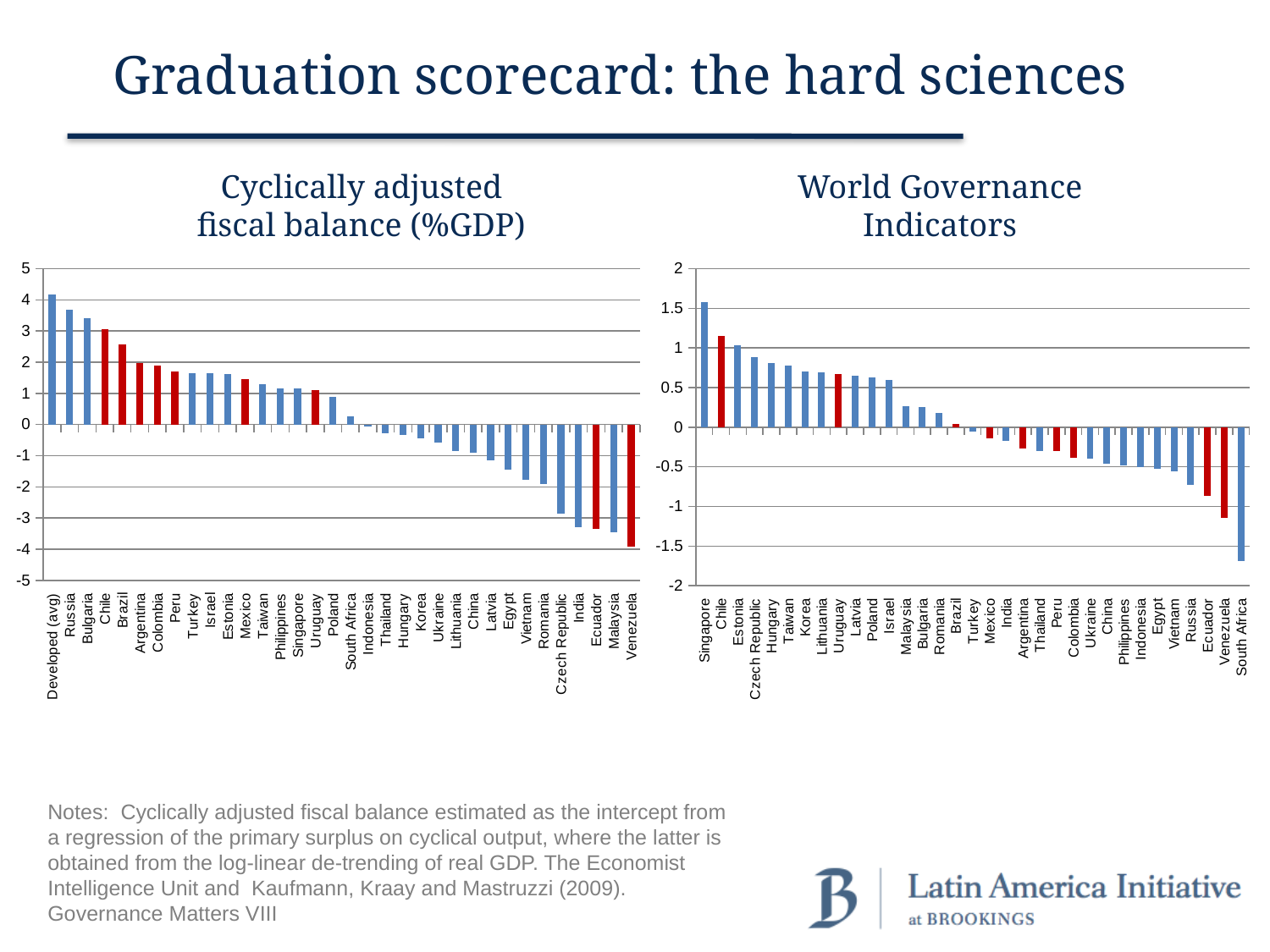
In the 'World Governance Indicators' chart, which category has the highest value? Singapore How many categories are shown in the 'Cyclically adjusted fiscal balance (%GDP)' chart? 34 In the 'World Governance Indicators' chart, is the value for Chile greater or less than 1? greater In the 'Cyclically adjusted fiscal balance (%GDP)' chart, which category has the highest value? Developed (avg) In the 'Cyclically adjusted fiscal balance (%GDP)' chart, which is larger, the value for Russia or the value for Bulgaria? Russia In the 'Cyclically adjusted fiscal balance (%GDP)' chart, is the value for India greater or less than -3? less What kind of chart is the 'Cyclically adjusted fiscal balance (%GDP)' chart? bar chart In the 'Cyclically adjusted fiscal balance (%GDP)' chart, is the value for Brazil greater or less than 2? greater In the 'World Governance Indicators' chart, do the values rise or fall moving from left to right along the x axis? fall In the 'Cyclically adjusted fiscal balance (%GDP)' chart, which category has the lowest value? Venezuela In the 'World Governance Indicators' chart, which category has the lowest value? South Africa